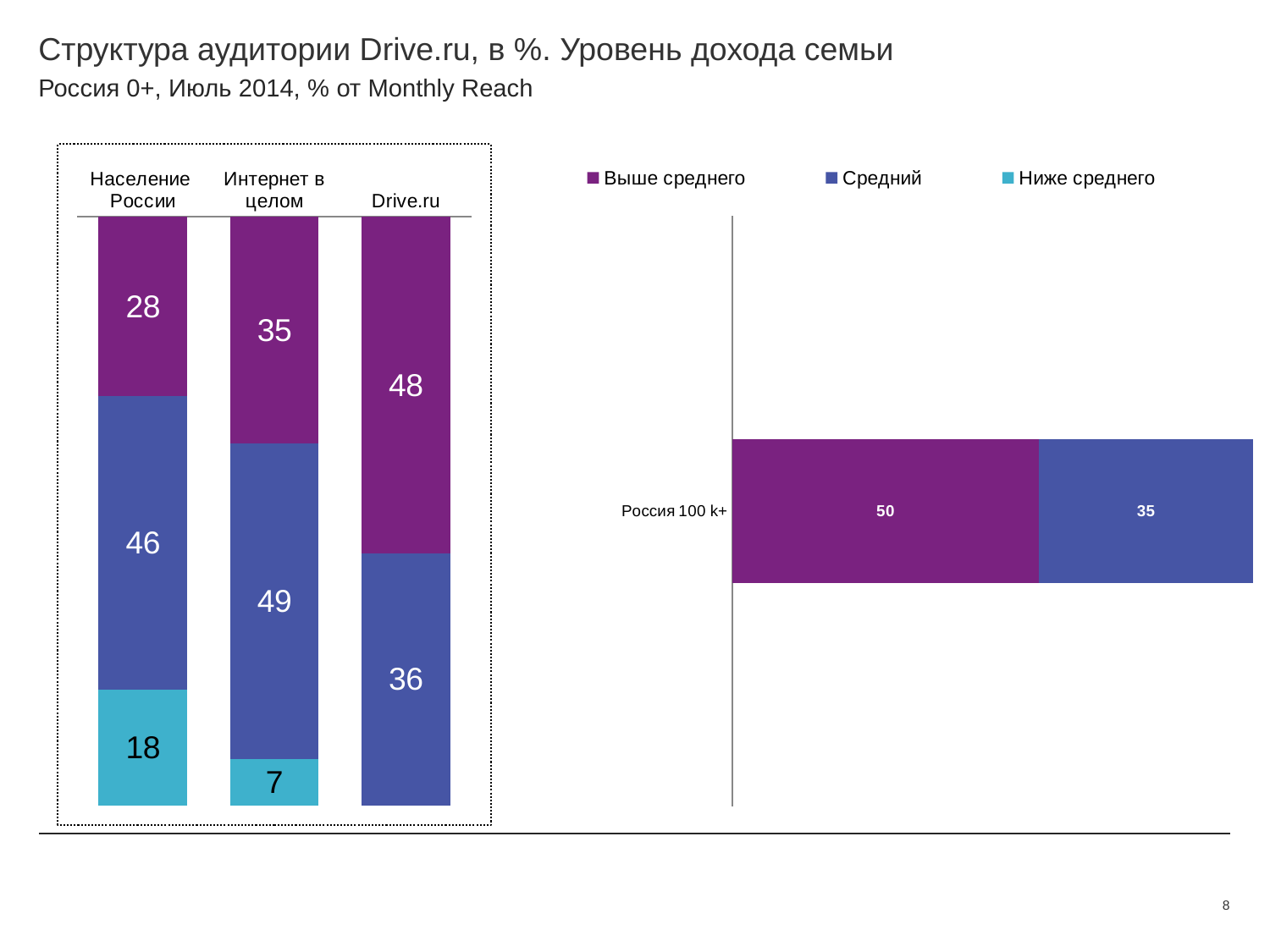
In the left stacked bar chart, what is the value of the 'Выше среднего' segment for Drive.ru? 48 In the right chart, what is the 'Выше среднего' value for Россия 100 k+? 50 In the left stacked bar chart, what is the value of the 'Ниже среднего' segment for Население России? 18 In the left stacked bar chart, which category has the highest 'Выше среднего' value? Drive.ru In the left stacked bar chart, how many categories are shown on the x axis? 3 How many series does the legend list? 3 In the left stacked bar chart, what is the value of the 'Средний' segment for Интернет в целом? 49 In the left stacked bar chart, what is the difference between the 'Выше среднего' values for Drive.ru and Население России? 20 In the left stacked bar chart, which is larger: the 'Средний' value for Население России or for Drive.ru? Население России In the left stacked bar chart, which category has the lowest 'Ниже среднего' value among those with a labelled segment? Интернет в целом What type of chart is the chart on the right of the slide? Stacked bar chart In the right chart, what is the total of the two labelled segments for Россия 100 k+? 85